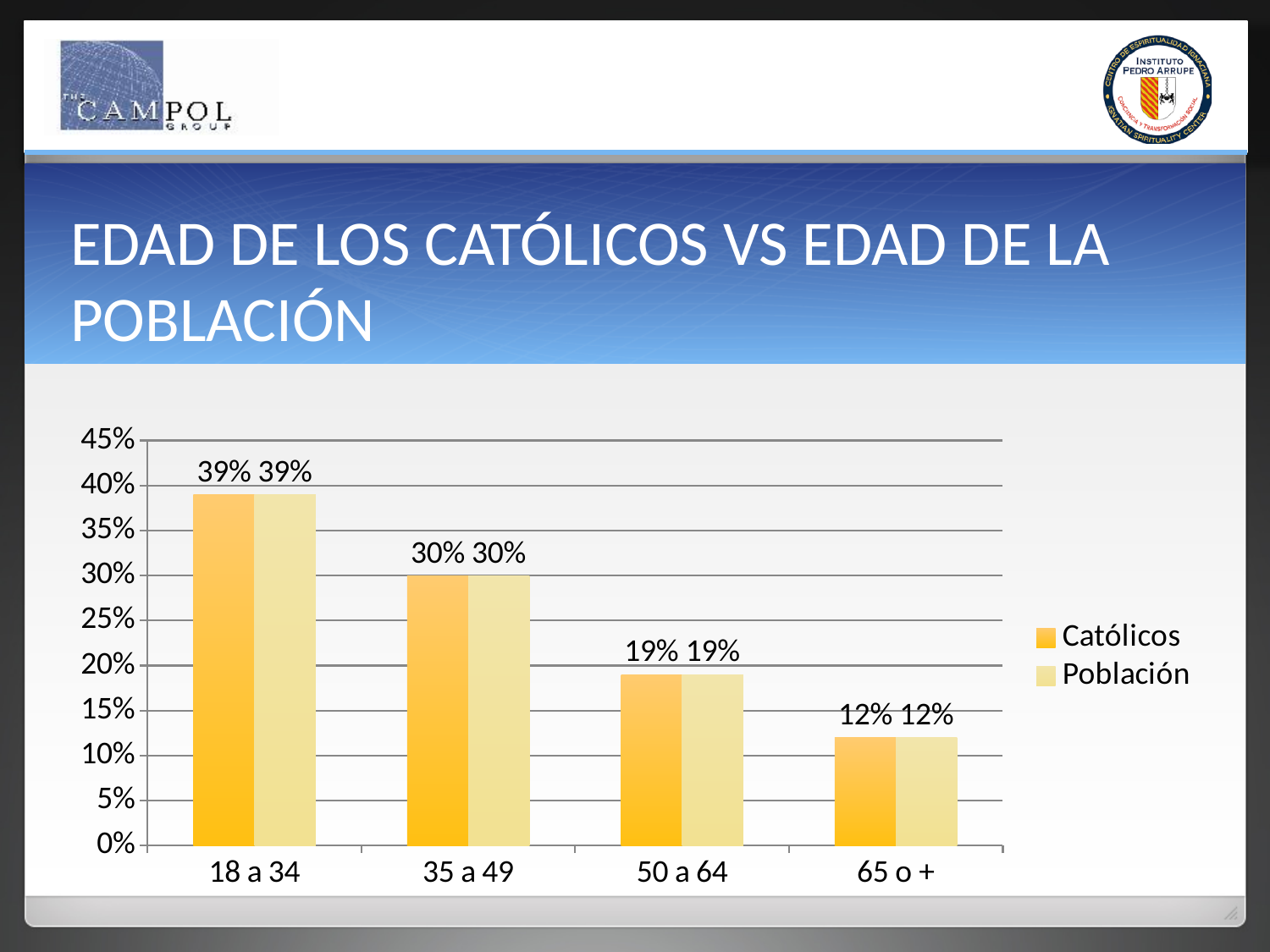
What is the value for Población in the 50 a 64 age group? 19% What is the value for Católicos in the 18 a 34 age group? 39% What kind of chart is shown on the slide? Bar chart Which is larger: the Católicos value for 50 a 64 or the Católicos value for 65 o +? 50 a 64 What is the value for Católicos in the 65 o + age group? 12% How many age groups are shown on the x axis? 4 Do the Población values rise or fall from 18 a 34 to 65 o +? Fall Which age group has the highest value for Católicos? 18 a 34 What is the value for Población in the 35 a 49 age group? 30% Which age group has the lowest value for Población? 65 o + What is the difference between the Católicos values for 18 a 34 and 35 a 49? 9% How many series does the legend list? 2